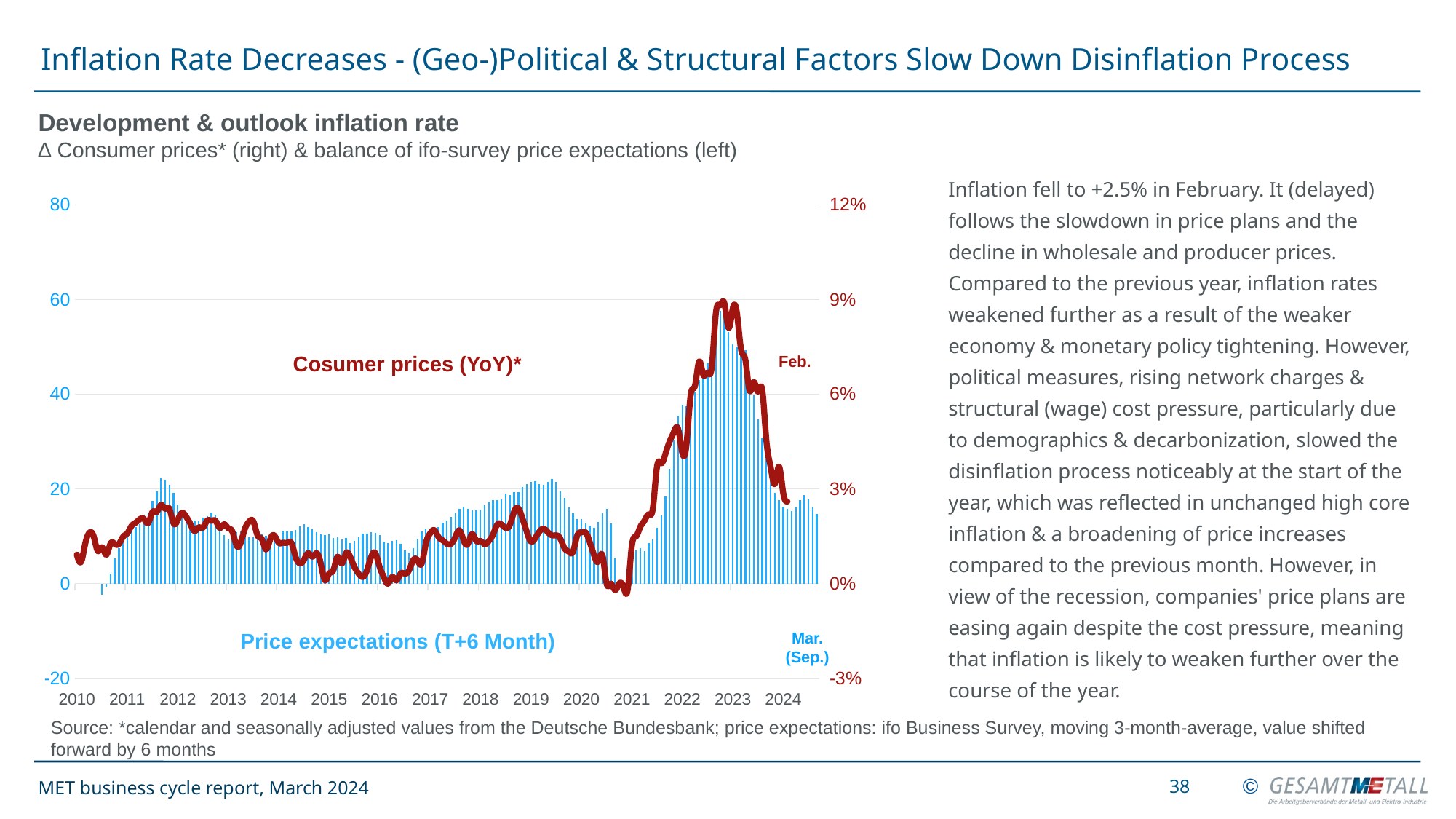
Is the value of the Consumer prices (YoY)* line at its last point in 2024 greater or less than 6%? less How many year labels are shown on the x axis? 15 Does the Consumer prices (YoY)* line rise or fall between 2021 and 2022? rise Does the Consumer prices (YoY)* line rise or fall from 2023 to 2024? fall How many data series are plotted in the chart? 2 Are the Price expectations (T+6 Month) bars in 2016 greater or less than 20? less Is the peak value of the Consumer prices (YoY)* line in 2022 greater or less than 6%? greater What month label is attached to the latest point of the Consumer prices (YoY)* line? Feb. Which series is plotted against the right-hand axis? Consumer prices (YoY)* What kind of chart is shown on the slide? A combined bar and line chart